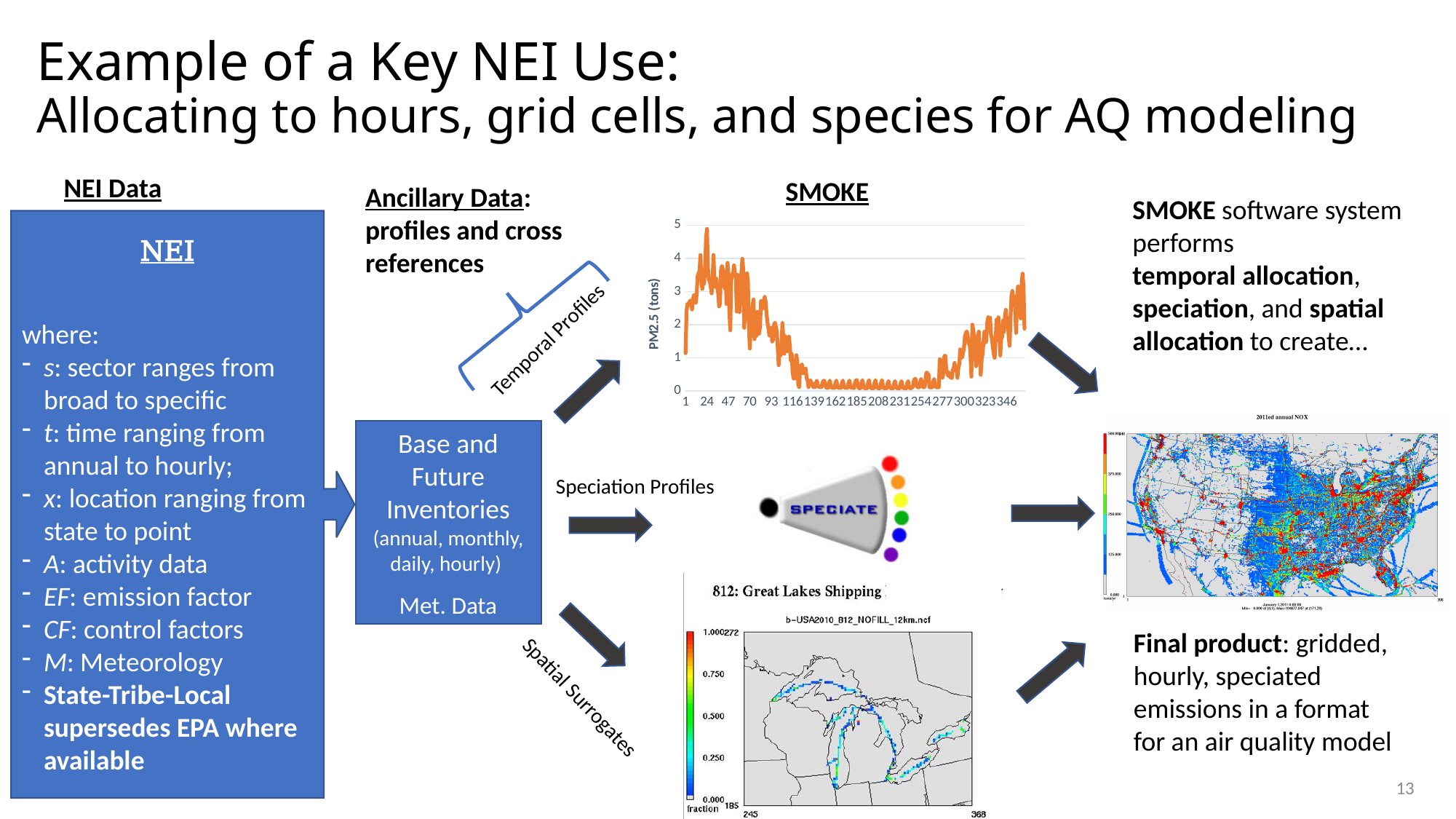
What kind of chart is shown under the SMOKE heading? line chart In the SMOKE line chart, do the values rise or fall between x = 254 and x = 346? rise In the SMOKE line chart, do the values rise or fall between x = 47 and x = 139? fall In the SMOKE line chart, is the value at x = 185 greater or less than 1? less How many tick labels are shown on the horizontal axis of the SMOKE line chart? 16 What is the highest tick value shown on the vertical axis of the SMOKE line chart? 5 In the SMOKE line chart, which is larger: the value around x = 24 or the value around x = 185? the value around x = 24 What colour is the line plotted in the SMOKE line chart? orange In the SMOKE line chart, is the peak value near the start of the series greater or less than 4? greater What is the last tick label shown on the horizontal axis of the SMOKE line chart? 346 What is the label on the vertical axis of the SMOKE line chart? PM2.5 (tons) In the SMOKE line chart, is the value at x = 1 greater or less than 2? less